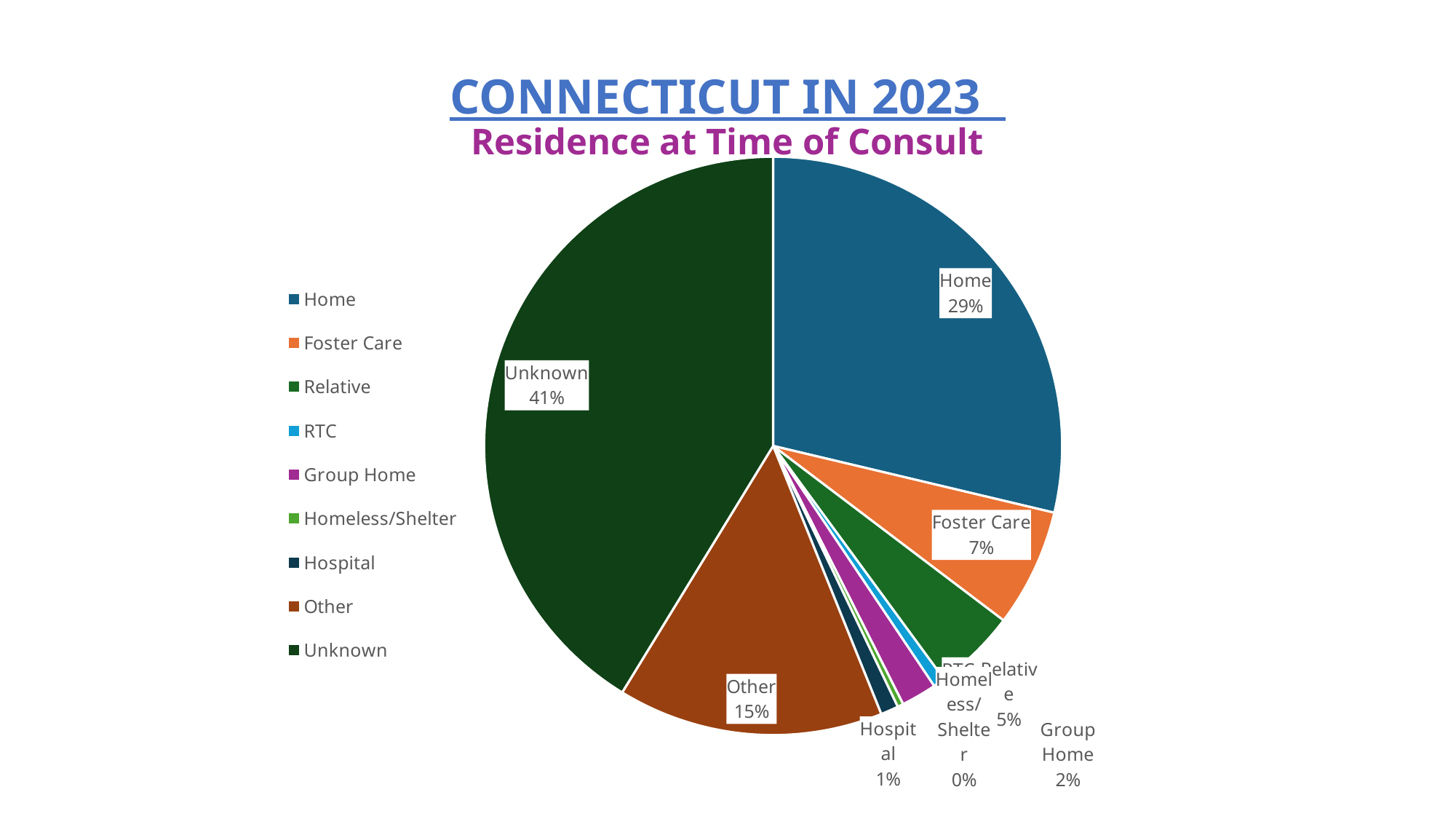
Which category has the largest slice? Unknown What is the difference in percentage points between Unknown and Home? 12 What share of the pie is Home? 29% How many categories does the legend list? 9 Which is larger, Foster Care or Relative? Foster Care What is the chart's title? Residence at Time of Consult What share of the pie is Hospital? 1% What share of the pie is Other? 15% What kind of chart is shown on the slide? pie chart Which category has the smallest slice? Homeless/Shelter